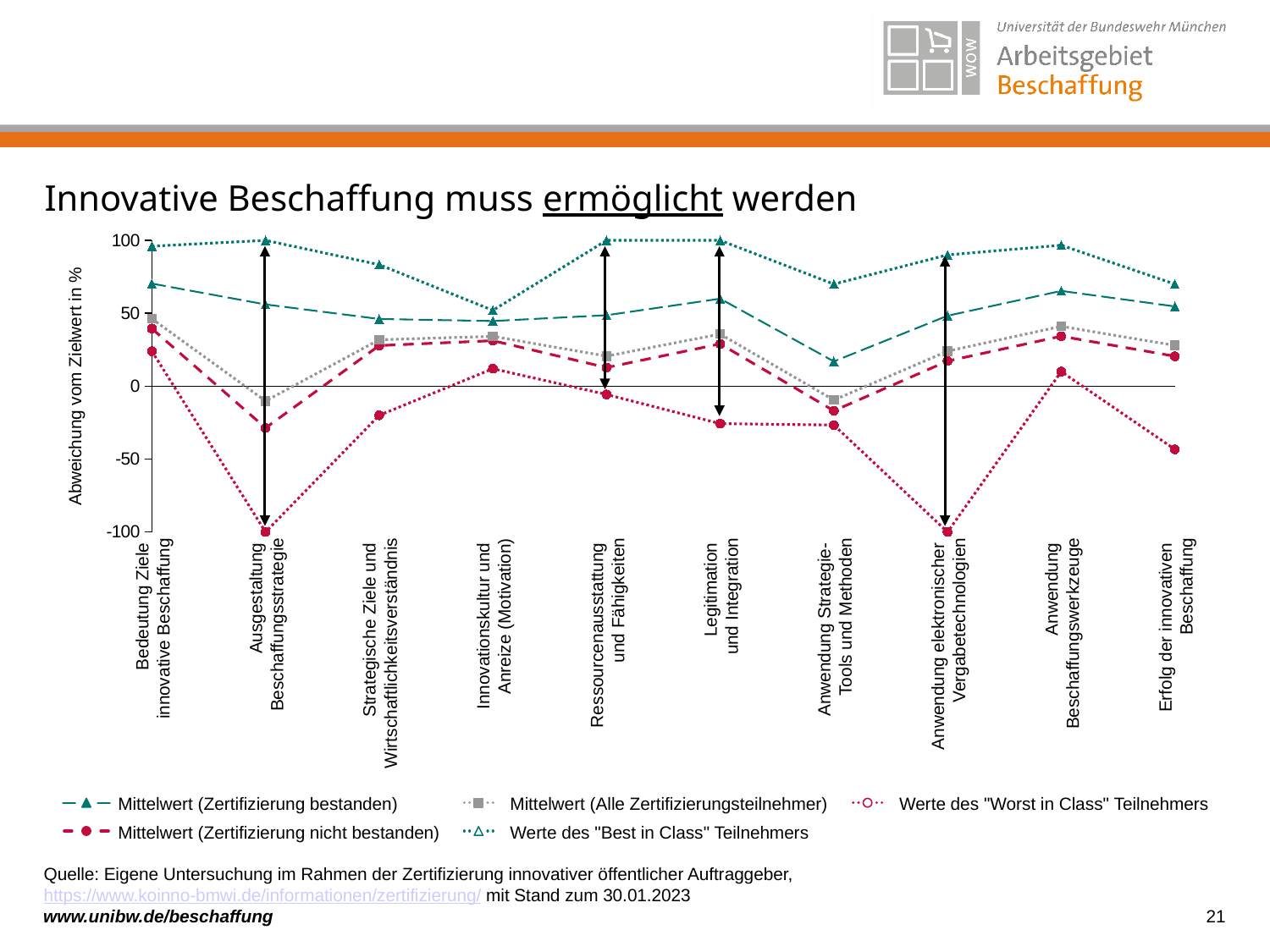
Is the value of the "Worst in Class" series for Erfolg der innovativen Beschaffung greater or less than 0? less Is the value of Mittelwert (Zertifizierung nicht bestanden) for Ausgestaltung Beschaffungsstrategie greater or less than 0? less How many categories are shown along the x axis of the chart? 10 For Bedeutung Ziele innovative Beschaffung, which is larger: Mittelwert (Zertifizierung bestanden) or Mittelwert (Zertifizierung nicht bestanden)? Mittelwert (Zertifizierung bestanden) What is the label of the vertical axis of the chart? Abweichung vom Zielwert in % What kind of chart is shown on the slide? line chart For which category is the Mittelwert (Zertifizierung bestanden) series lowest? Anwendung Strategie-Tools und Methoden What is the value of the "Worst in Class" series for Anwendung elektronischer Vergabetechnologien? -100 What is the value of the "Best in Class" series for Ausgestaltung Beschaffungsstrategie? 100 What is the value of the "Best in Class" series for Legitimation und Integration? 100 Is the value of Mittelwert (Zertifizierung bestanden) for Bedeutung Ziele innovative Beschaffung greater or less than 50? greater How many series does the chart legend list? 5